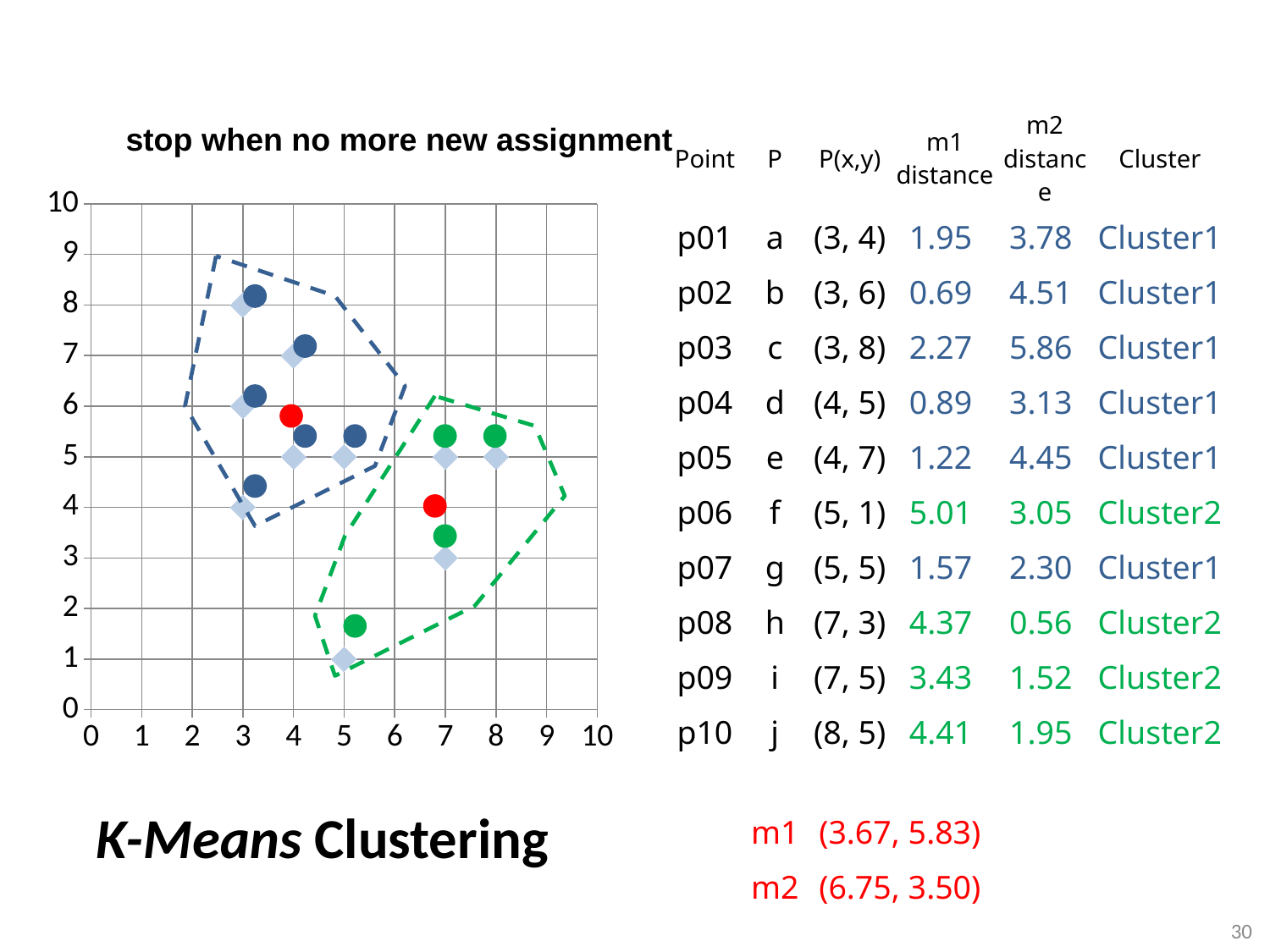
Which point has the lowest y value in the chart? f What is the highest value shown on the chart's y axis? 10 What are the (x, y) coordinates of point h? (7, 3) What kind of chart is shown on the left of the slide? scatter chart How many data points (a through j) are plotted in the chart? 10 Is the y value of point f greater or less than 2? less Which cluster contains more points, Cluster1 or Cluster2? Cluster1 Which cluster is point g (5, 5) assigned to? Cluster1 What is the title shown above the chart? stop when no more new assignment What is the m1 distance for point p04? 0.89 Which point has the highest y value in the chart? c What are the coordinates of centroid m2? (6.75, 3.50)